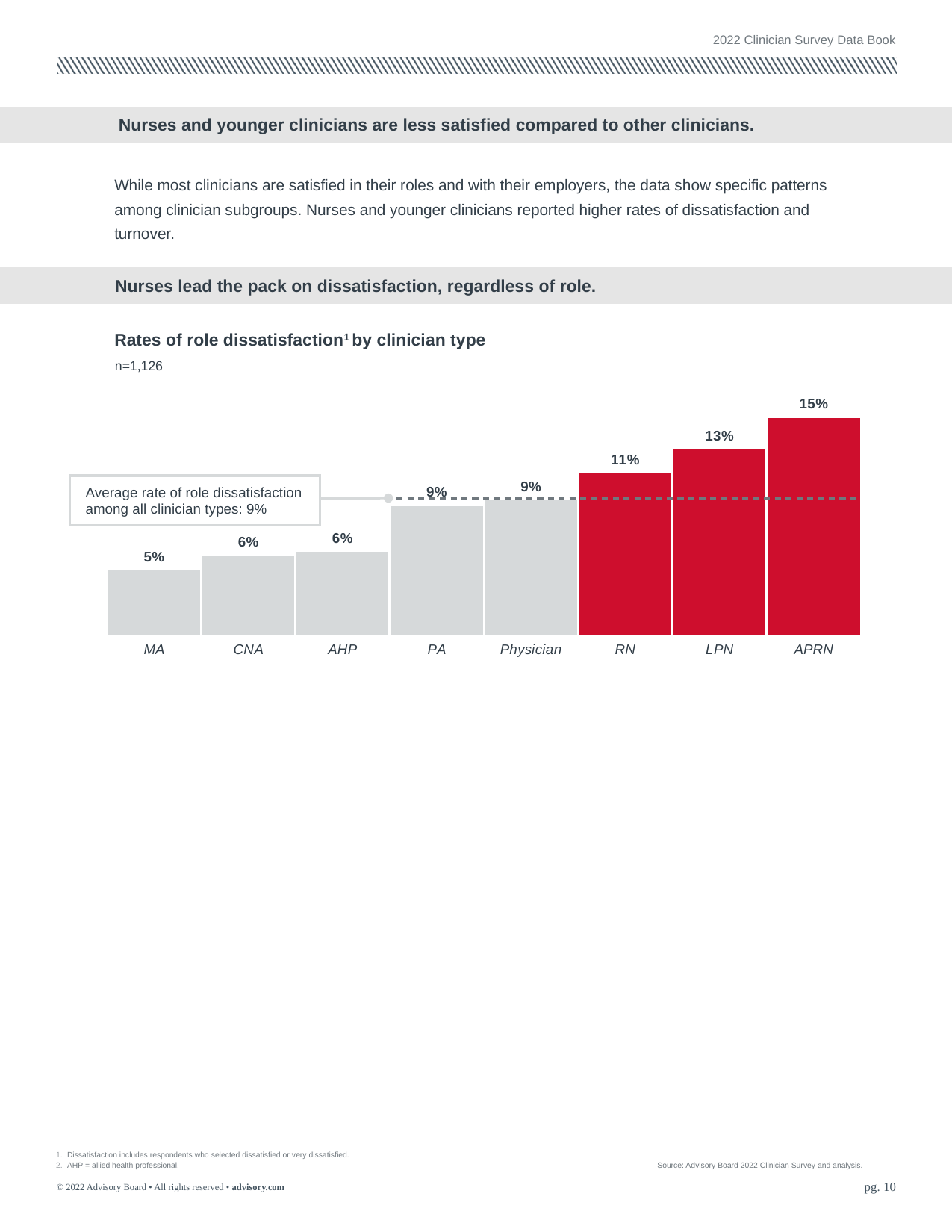
Which clinician type has the highest rate of role dissatisfaction? APRN What is the difference between the dissatisfaction rates for APRN and LPN? 2% How many clinician types are shown in the chart? 8 What is the average rate of role dissatisfaction among all clinician types shown by the dashed line? 9% What is the rate of role dissatisfaction for MA? 5% What is the rate of role dissatisfaction for RN? 11% Which has a higher rate of role dissatisfaction, LPN or PA? LPN Which clinician type has the lowest rate of role dissatisfaction? MA What is the rate of role dissatisfaction for Physician? 9% What kind of chart is used to show rates of role dissatisfaction by clinician type? Bar chart What is the difference between the dissatisfaction rates for RN and CNA? 5% Do the dissatisfaction rates rise or fall from left to right across the clinician types? Rise